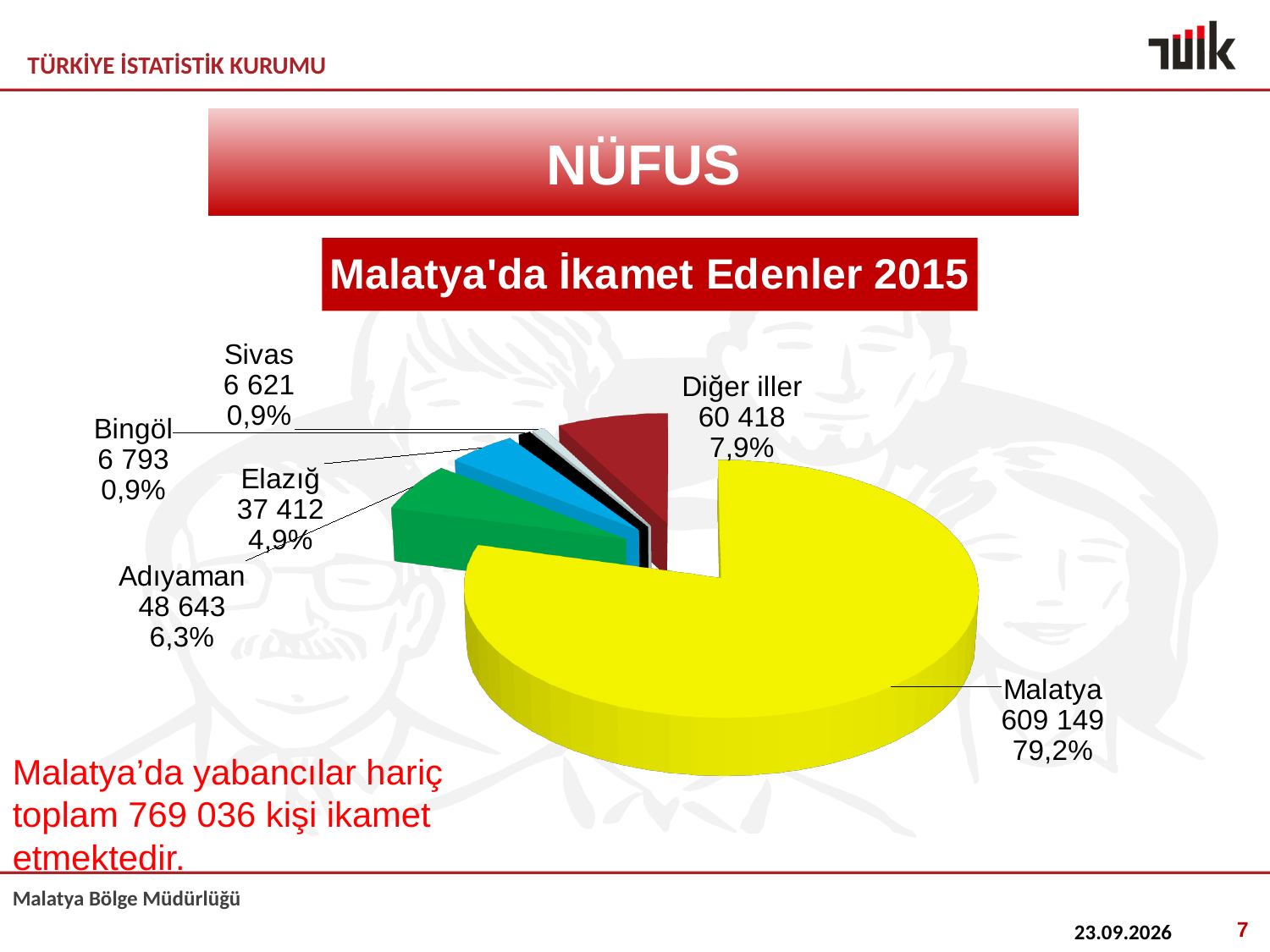
What is the value shown for Adıyaman? 48 643 What percentage share does Malatya have in the pie chart? 79,2% Which category has the largest slice in the pie chart? Malatya How many slices does the pie chart have? 6 What is the difference between the values for Adıyaman and Elazığ? 11 231 What percentage share does Elazığ have in the pie chart? 4,9% What is the title of the chart? Malatya'da İkamet Edenler 2015 Which is larger, the value for Diğer iller or the value for Adıyaman? Diğer iller What is the value shown for Diğer iller? 60 418 What type of chart is shown on the slide? Pie chart What is the value shown for Malatya? 609 149 Which category has the smallest value in the pie chart? Sivas